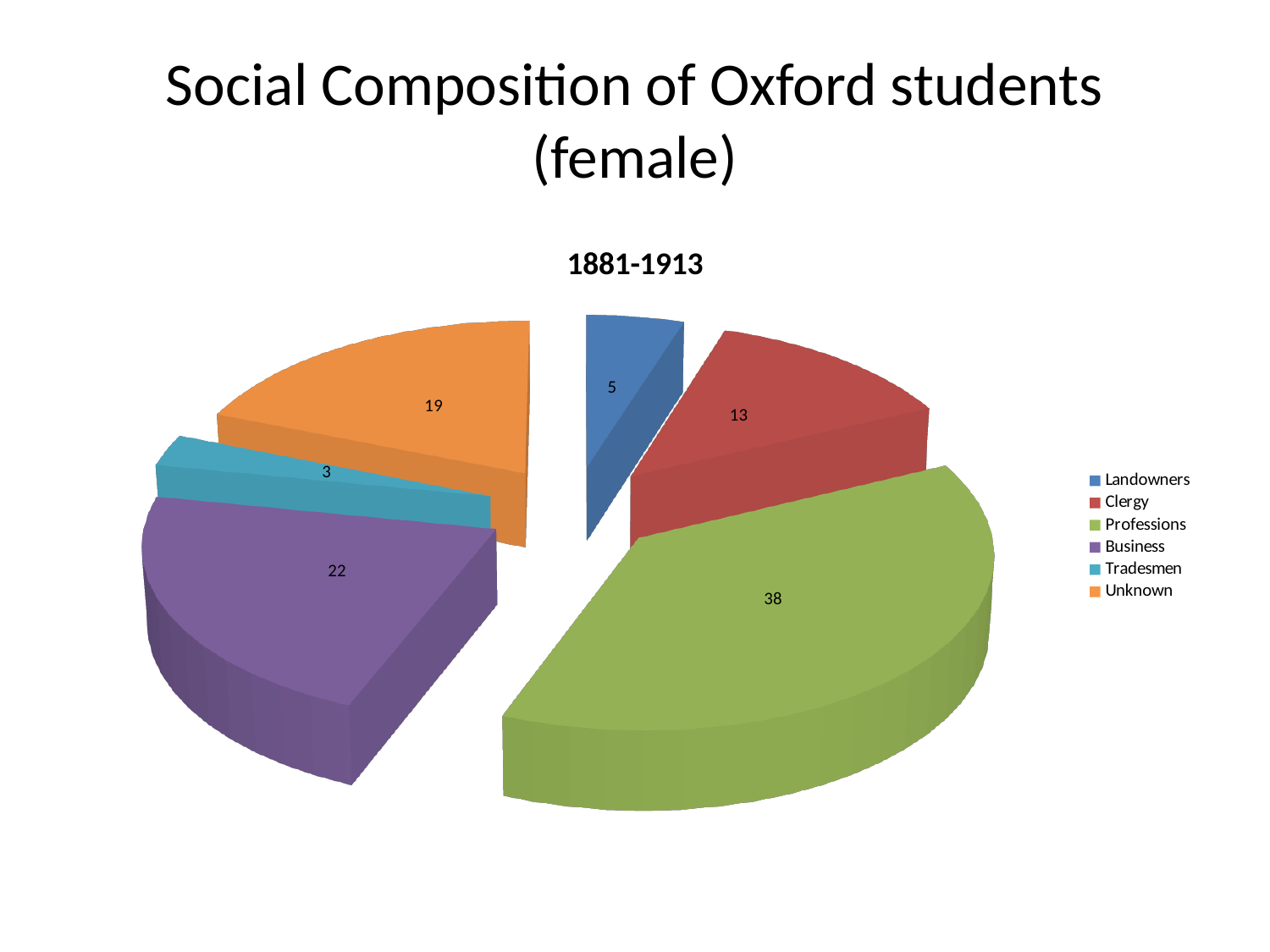
Which category has the largest slice? Professions How many categories does the pie chart have? 6 What is the value for Unknown? 19 What colour is the Business slice? purple What is the value for Business? 22 Which is larger, the value for Clergy or the value for Unknown? Unknown What is the title shown above the pie chart? 1881-1913 Which category has the smallest slice? Tradesmen What is the value for Professions? 38 What is the value for Landowners? 5 What kind of chart is shown on the slide? pie chart What is the difference between the values for Professions and Business? 16